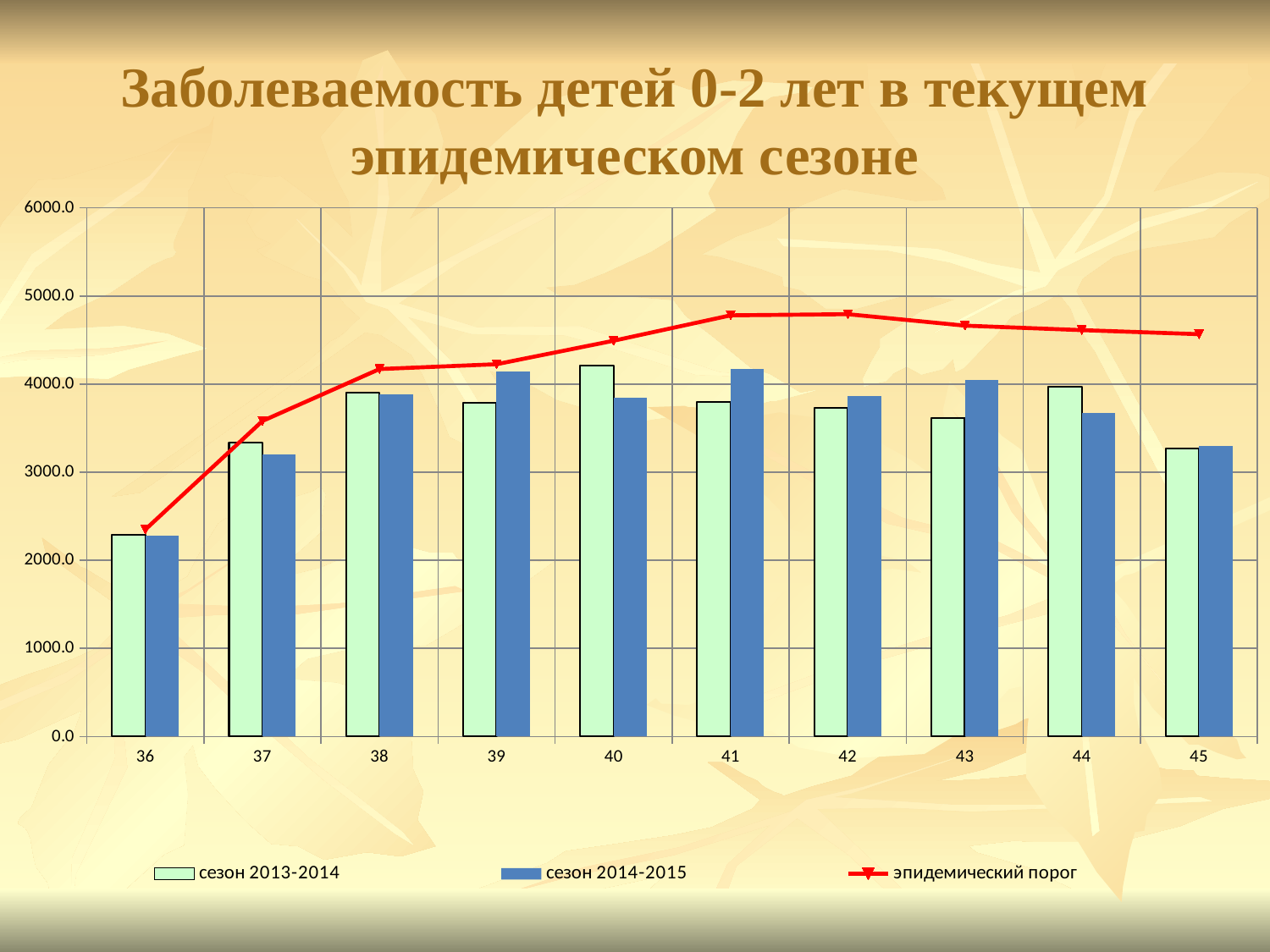
In week 43, which is larger: сезон 2013-2014 or сезон 2014-2015? сезон 2014-2015 In which week is the value for сезон 2013-2014 highest? 40 Is the эпидемический порог value in week 41 greater or less than 5000.0? less What kind of chart is shown on the slide? bar chart with a line series Which series is drawn as a red line with triangle markers? эпидемический порог Does the эпидемический порог line rise or fall from week 36 to week 41? rise Is the value for сезон 2014-2015 in week 41 greater or less than 4000.0? greater How many week categories are shown on the x axis? 10 In which week is the value for сезон 2014-2015 lowest? 36 In which week is the value for сезон 2013-2014 lowest? 36 Is the value for сезон 2013-2014 in week 36 greater or less than 3000.0? less How many series does the legend list? 3